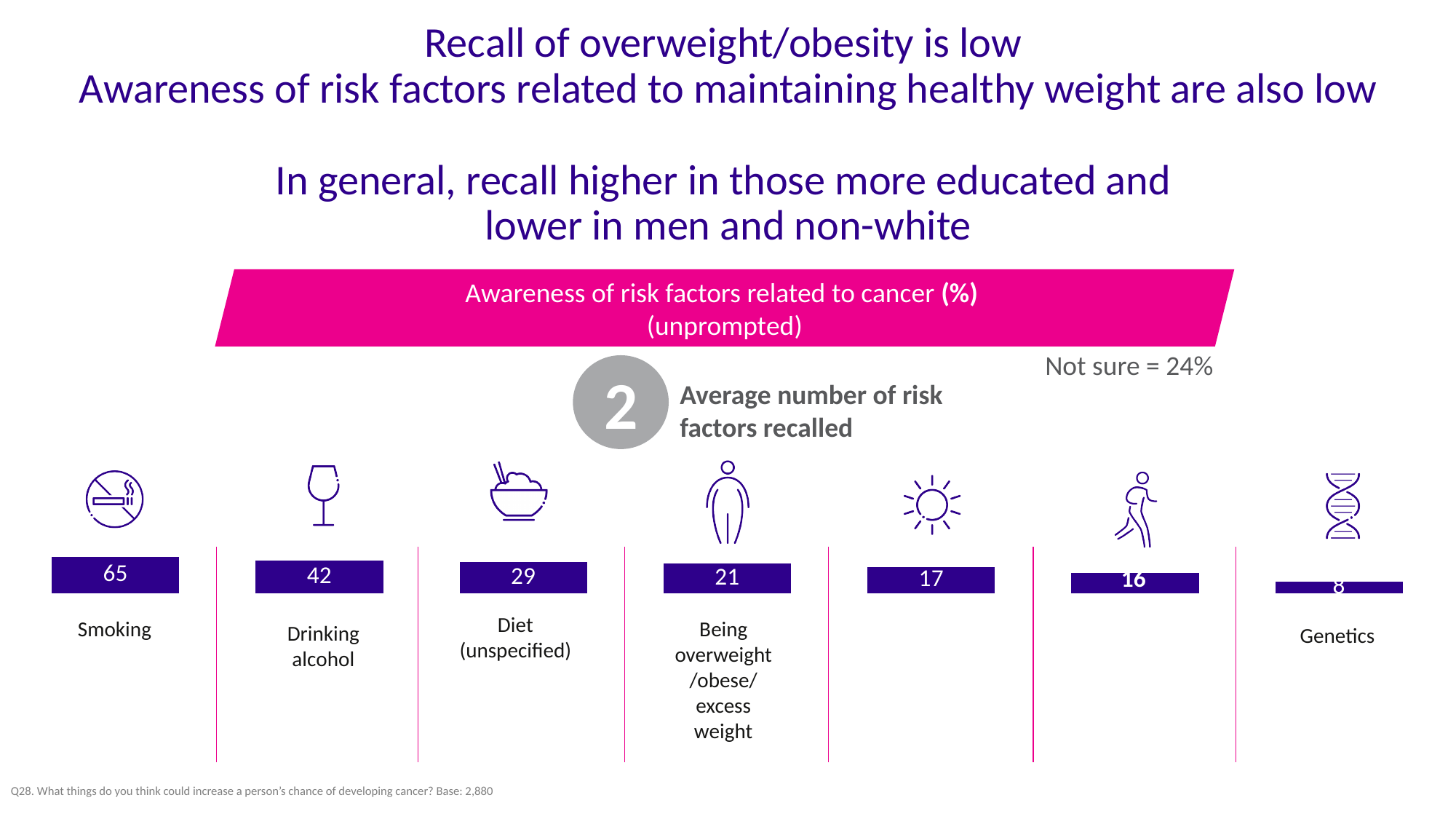
What percentage of respondents recalled smoking as a risk factor related to cancer? 65 What is the difference between the values for smoking and drinking alcohol? 23 What value is shown for genetics? 8 Which risk factor has the highest awareness value? Smoking What is the value shown for drinking alcohol? 42 Which has a higher value: diet (unspecified) or being overweight/obese/excess weight? Diet (unspecified) What kind of chart is used to show awareness of risk factors? Bar chart Do the values rise or fall moving from left to right across the bars? Fall What percentage of respondents were 'Not sure' according to the slide? 24% What value is shown for being overweight/obese/excess weight? 21 How many risk factor bars are shown on the slide? 7 Which labelled risk factor has the lowest awareness value? Genetics